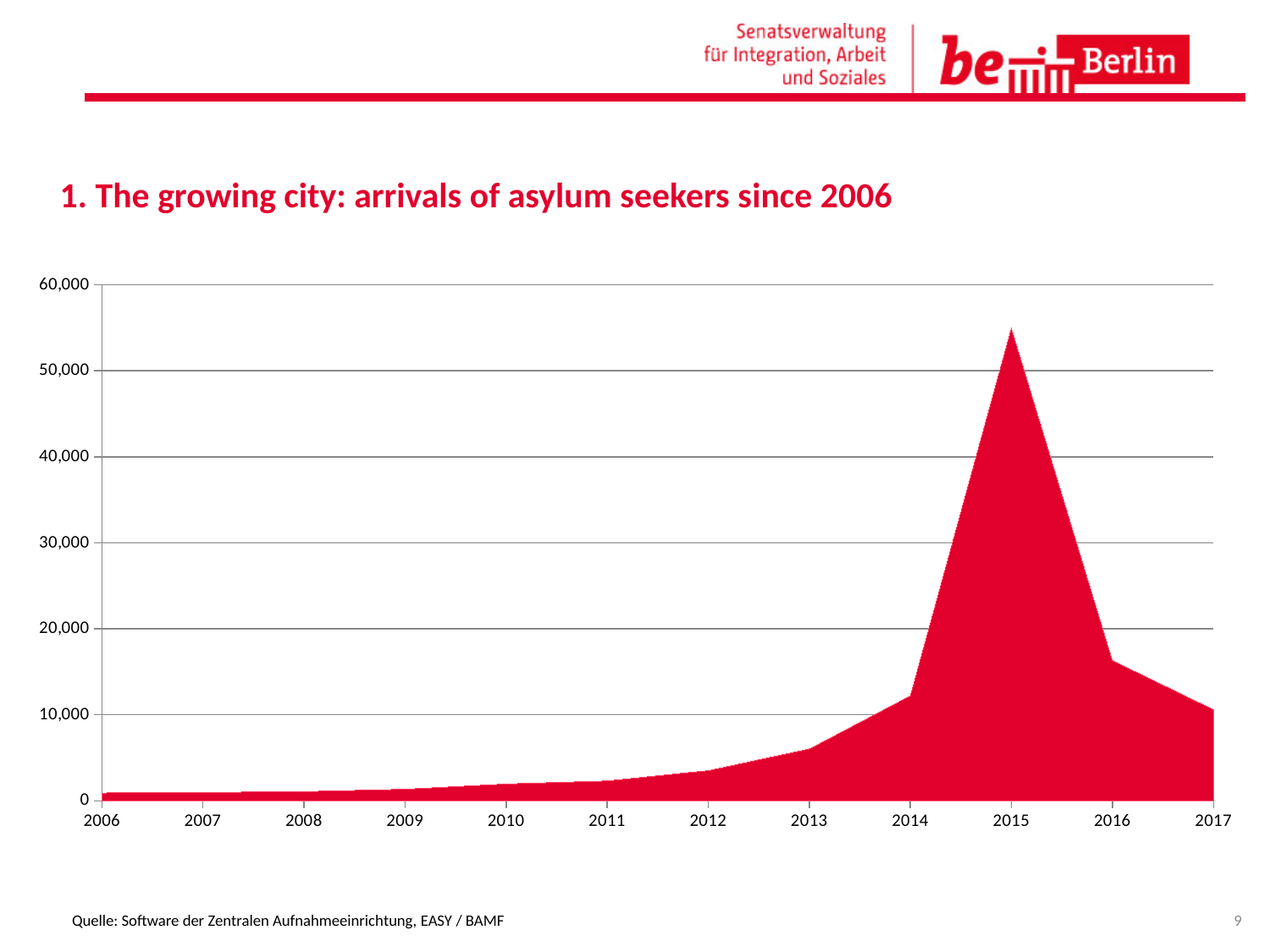
Which year has the larger value, 2015 or 2016? 2015 Which year has the highest number of arrivals of asylum seekers? 2015 Is the value for 2013 greater or less than 10,000? less What kind of chart is shown on the slide? area chart Which year has the larger value, 2013 or 2014? 2014 How many years are shown on the x axis of the chart? 12 Is the value for 2016 greater or less than 20,000? less Is the value for 2014 greater or less than 10,000? greater What is the title of the slide containing the chart? 1. The growing city: arrivals of asylum seekers since 2006 Do the values rise or fall from 2015 to 2017? fall